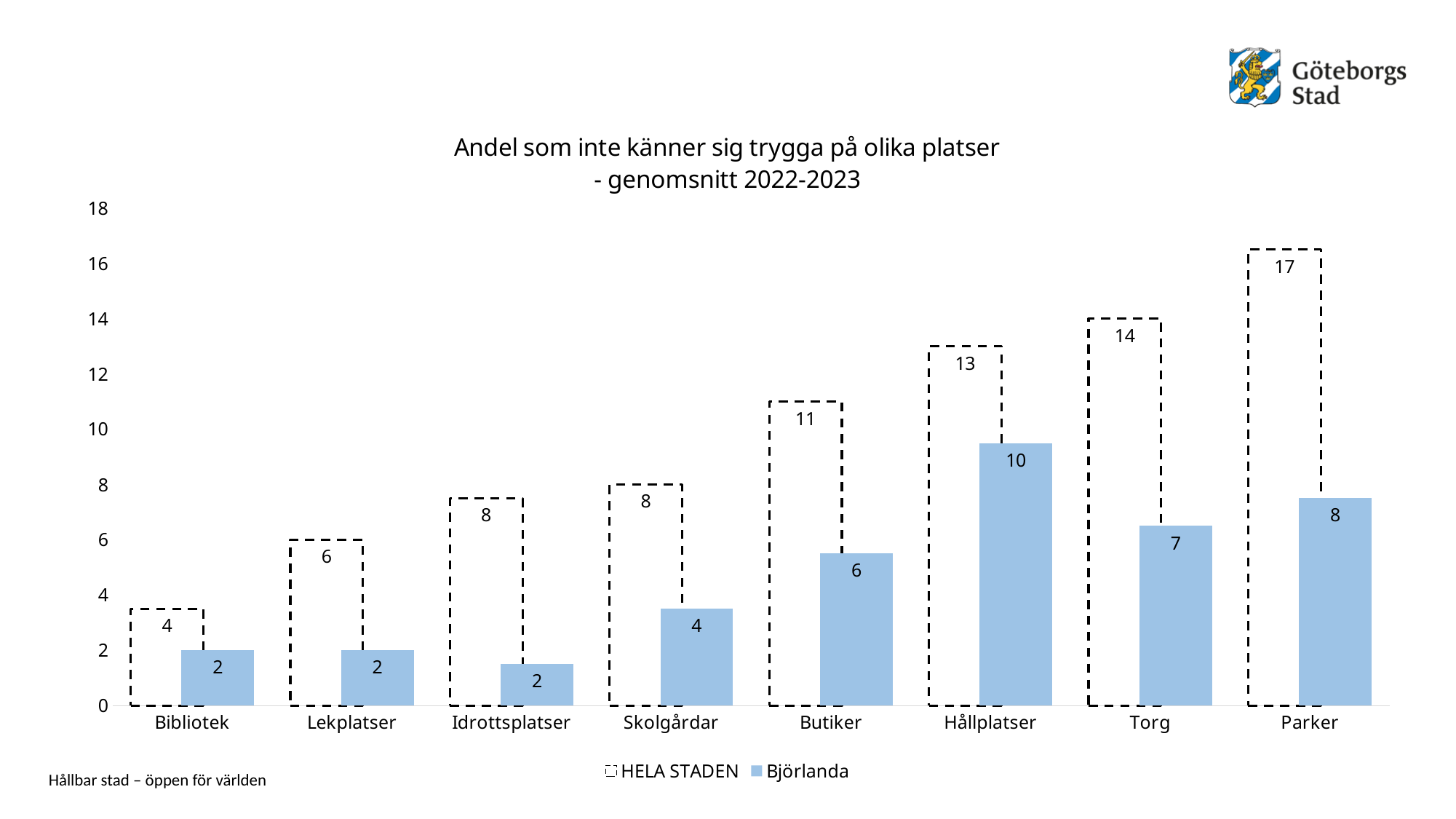
What is the value for HELA STADEN at Parker? 17 What is the value for Björlanda at Skolgårdar? 4 Which is larger at Butiker: the HELA STADEN value or the Björlanda value? HELA STADEN Which category has the highest HELA STADEN value? Parker Do the HELA STADEN values rise or fall from Bibliotek to Parker? rise Is the Björlanda value for Hållplatser greater or less than 8? greater What is the difference between the HELA STADEN and Björlanda values at Torg? 7 What kind of chart is shown on the slide? bar chart Which category has the lowest HELA STADEN value? Bibliotek How many categories are shown on the x axis? 8 How many series does the legend list? 2 What is the value for Björlanda at Hållplatser? 10